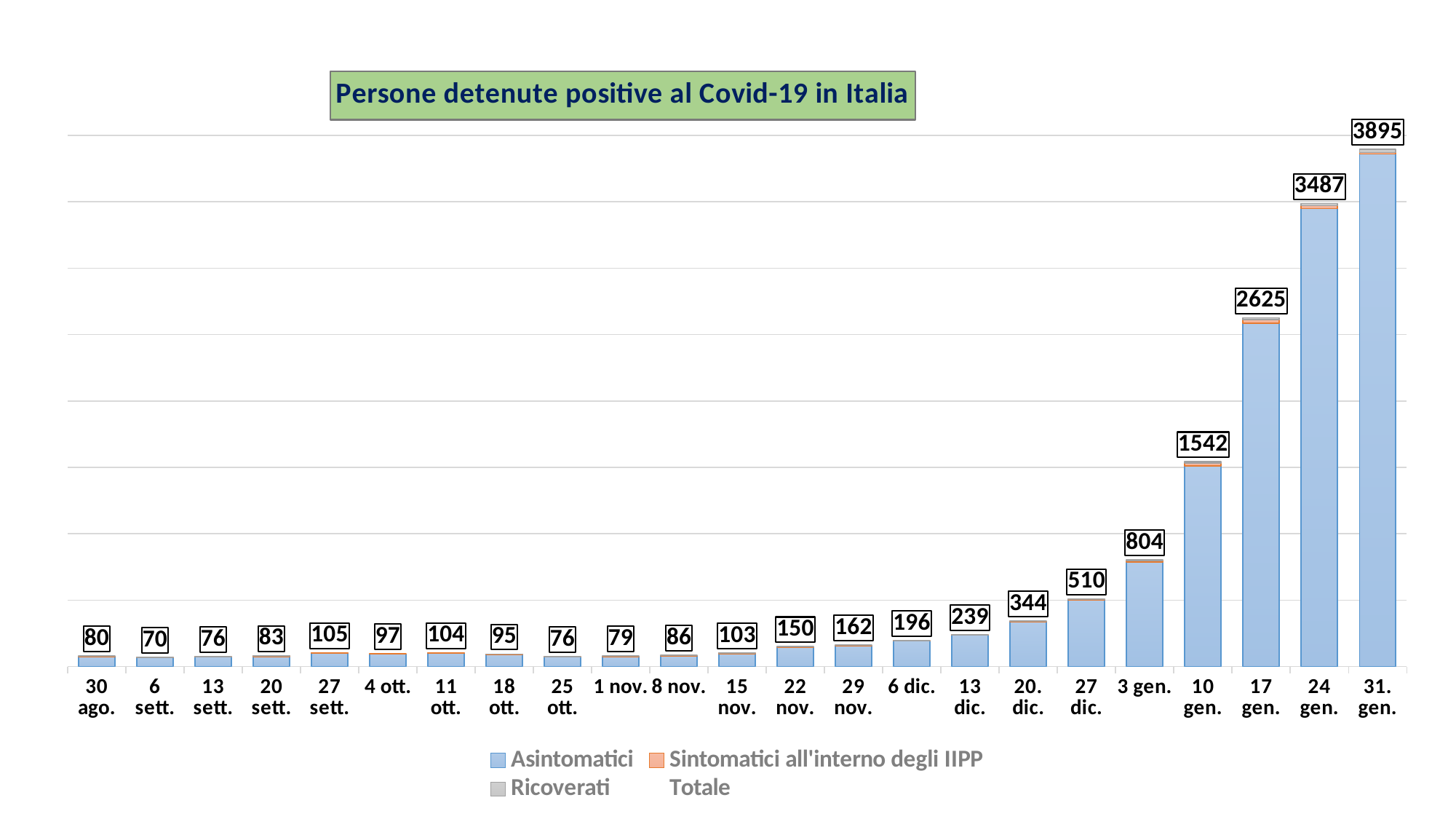
What is the total number of positive detainees shown for 31 gen.? 3895 How many dates are shown on the x axis? 23 Which date has the lowest total? 6 sett. What is the total value labelled for 15 nov.? 103 How many entries does the legend list? 4 What is the title of the chart? Persone detenute positive al Covid-19 in Italia What is the difference between the totals for 31 gen. and 24 gen.? 408 What kind of chart is this? Stacked bar chart Which is larger, the total for 27 sett. or the total for 4 ott.? 27 sett. What is the total value labelled for 3 gen.? 804 What is the difference between the totals for 10 gen. and 3 gen.? 738 Which date has the highest total? 31 gen.